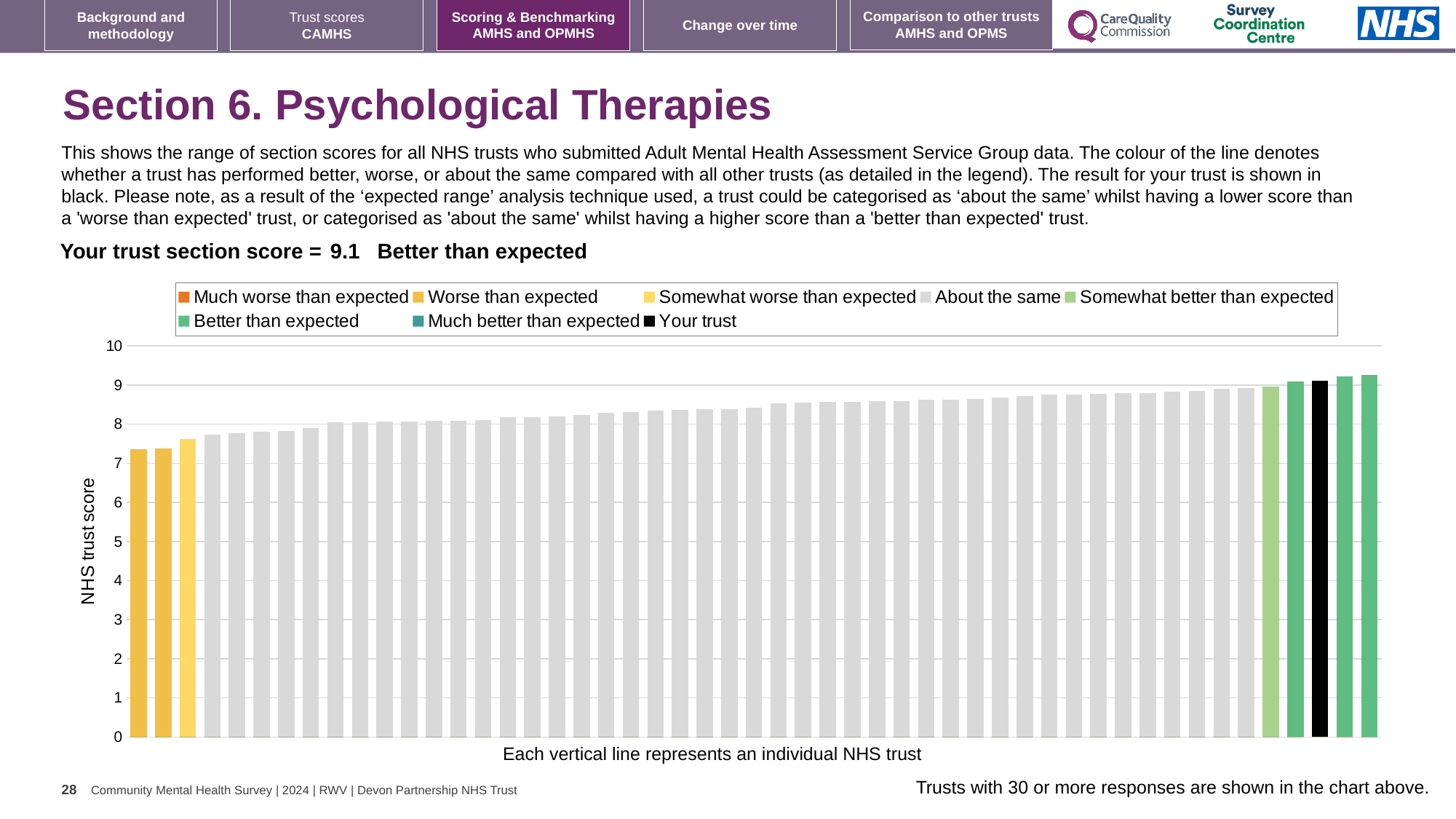
What colour is the bar representing Your trust? black What is the highest value shown on the vertical axis? 10 Is the value of the rightmost bar in the chart greater or less than 9? greater What is the section score for Your trust shown on the chart? 9.1 How many bars are coloured black for Your trust? 1 Is the value for Your trust greater or less than 5? greater Do the bar values rise or fall from left to right along the x axis? rise How many entries does the chart legend list? 8 What kind of chart is used to show the NHS trust scores? bar chart Which is larger: the value for Your trust or the value of the leftmost bar? Your trust What is the label on the vertical axis of the chart? NHS trust score Is the value of the leftmost bar in the chart greater or less than 8? less